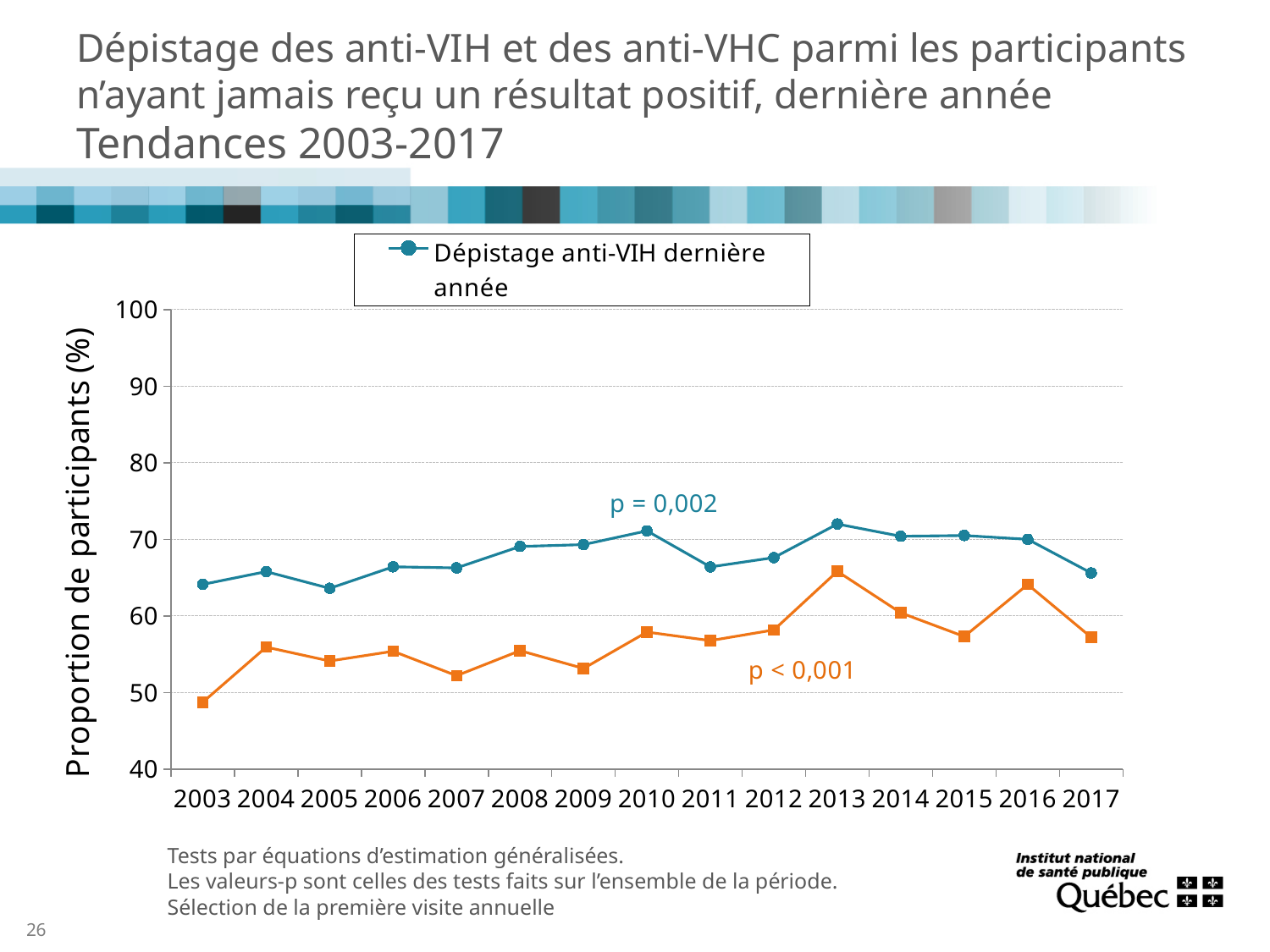
What kind of chart is shown on the slide? line chart Is the value for 'Dépistage anti-VIH dernière année' in 2013 greater or less than 70? greater Is the value for 'Dépistage anti-VIH dernière année' in 2003 greater or less than 60? greater How many years are plotted along the x axis? 15 Is the value of the orange line in 2003 greater or less than 50? less What is the label of the y axis? Proportion de participants (%) In which year does the 'Dépistage anti-VIH dernière année' series reach its highest value? 2013 In which year does the orange line reach its lowest value? 2003 Which series has the higher value in 2010, 'Dépistage anti-VIH dernière année' or the orange line? Dépistage anti-VIH dernière année Does the 'Dépistage anti-VIH dernière année' series rise or fall between 2003 and 2013? rise What p-value is printed next to the 'Dépistage anti-VIH dernière année' line? p = 0,002